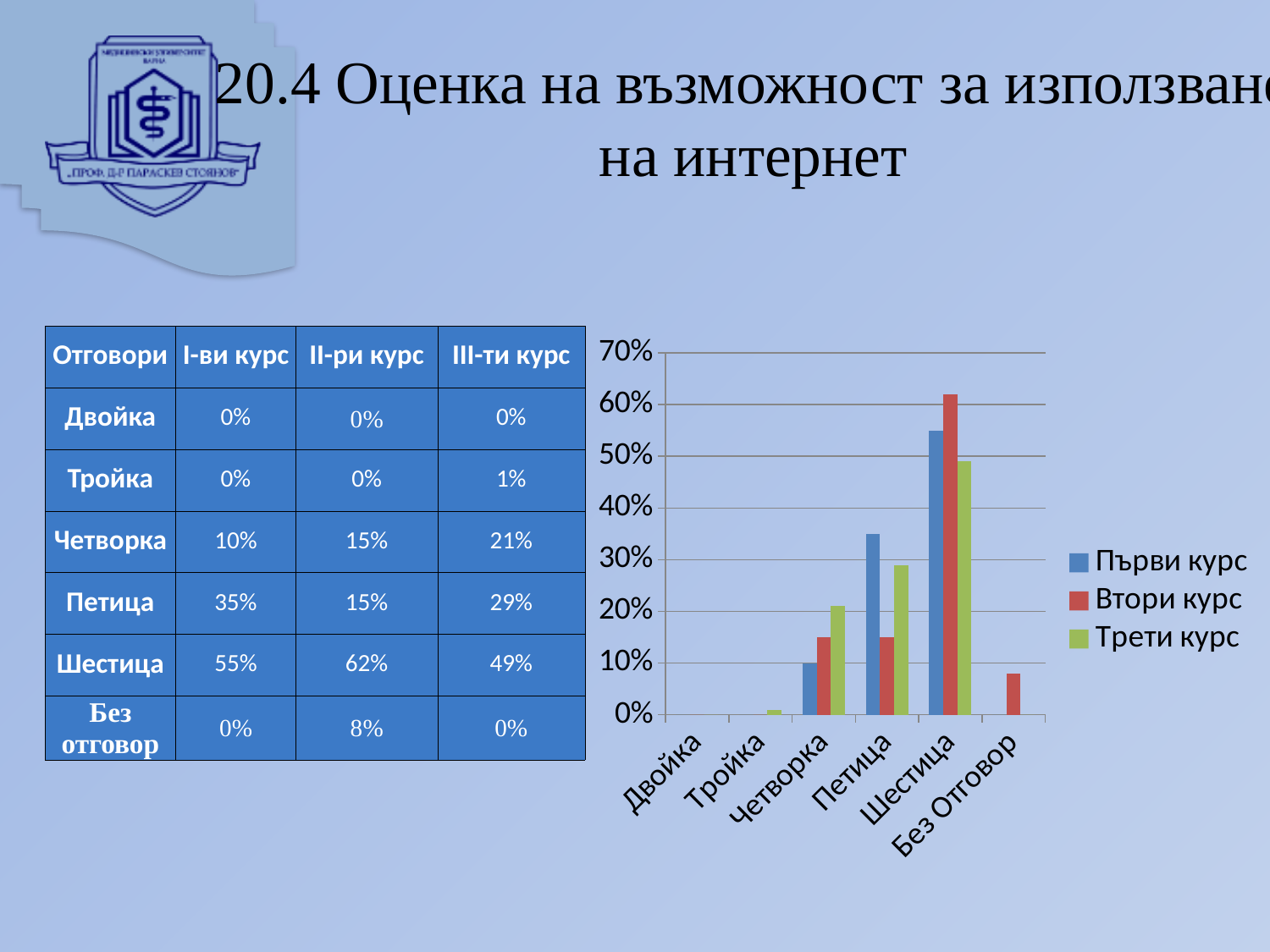
How many series does the chart legend list? 3 How many categories are shown on the x axis of the chart? 6 Which series has the lowest bar in the Шестица category? Трети курс In the Петица category, which is larger: Първи курс or Трети курс? Първи курс For which category is the Първи курс bar highest? Шестица Is the value for Първи курс in the Петица category greater or less than 30%? greater Is the value for Втори курс in the Шестица category greater or less than 60%? greater What is the value for Втори курс in the Шестица category? 62% What is the difference between Втори курс and Трети курс in the Шестица category? 13% What kind of chart is shown on the slide? bar chart What colour represents Трети курс in the chart legend? green What is the value for Втори курс in the Без Отговор category? 8%